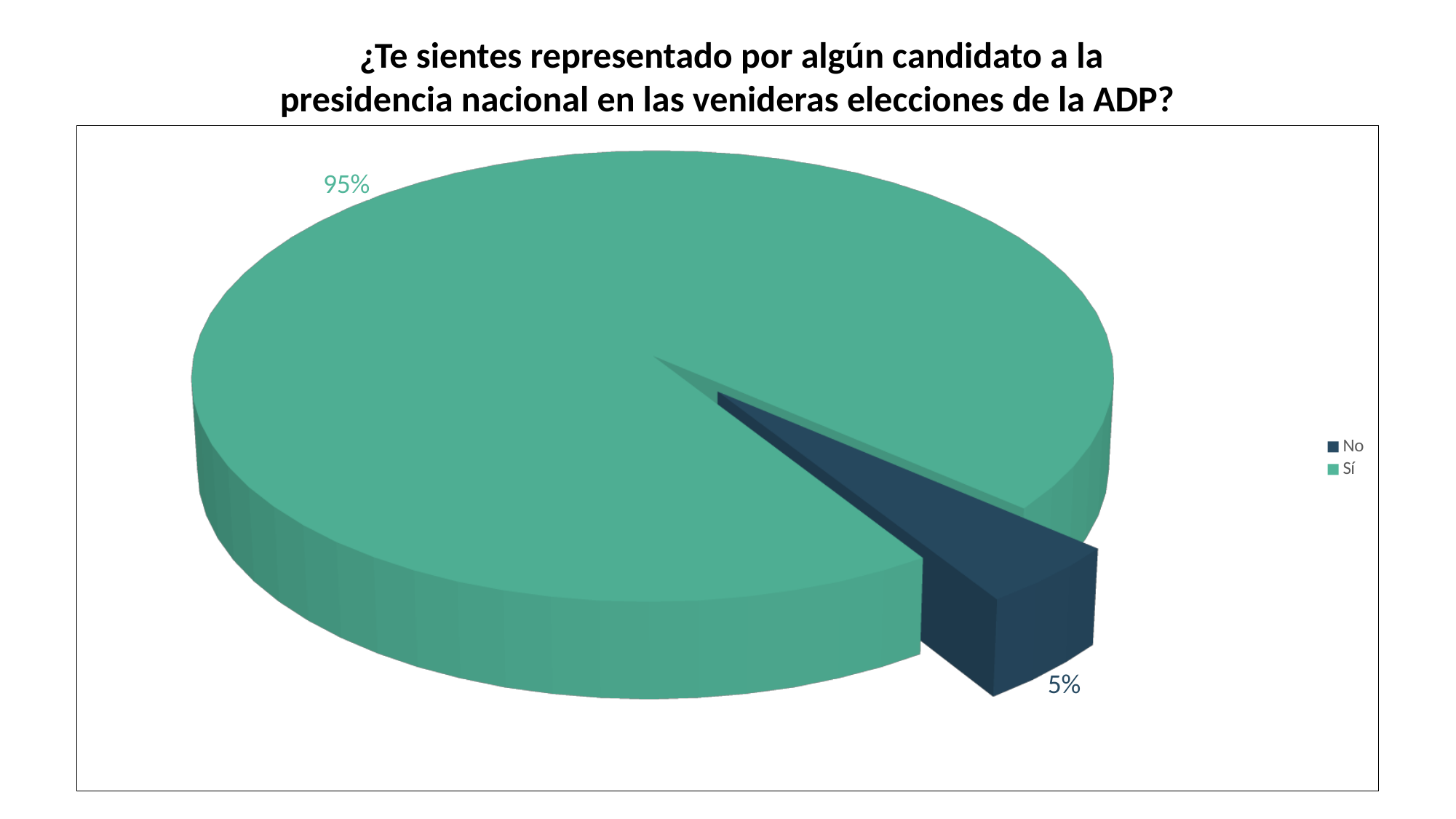
What percentage of respondents answered "No"? 5% What colour is the "No" slice in the pie chart? Dark blue Which is larger, the share for "Sí" or the share for "No"? Sí What share of the pie does the "No" slice represent? 5% What percentage of respondents answered "Sí"? 95% How many slices does the pie chart have? 2 How many entries does the legend list? 2 What kind of chart is shown on the slide? Pie chart Which response has the largest share of the pie? Sí What is the title of the chart? ¿Te sientes representado por algún candidato a la presidencia nacional en las venideras elecciones de la ADP? Which response has the smallest share of the pie? No What is the difference in percentage points between the "Sí" and "No" slices? 90